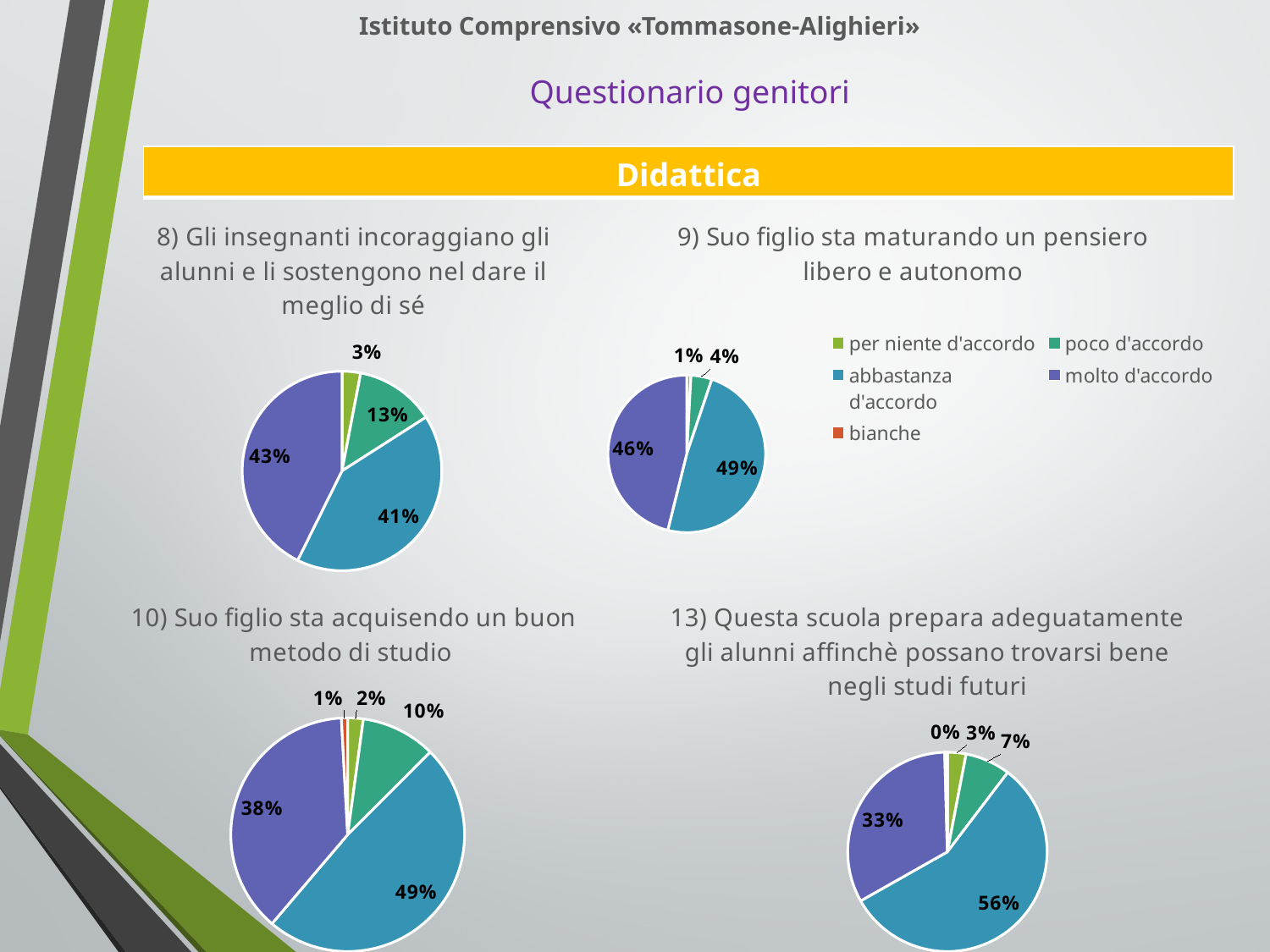
In the chart for question 10 (Suo figlio sta acquisendo un buon metodo di studio), what percentage is shown for 'abbastanza d'accordo'? 49% In the chart for question 13, which is larger: 'molto d'accordo' or 'abbastanza d'accordo'? abbastanza d'accordo In the chart for question 13, what percentage is shown for 'poco d'accordo'? 7% In the chart for question 9 (Suo figlio sta maturando un pensiero libero e autonomo), which response has the largest share? abbastanza d'accordo How many entries does the shared legend list? 5 In the chart for question 8 (Gli insegnanti incoraggiano gli alunni...), what percentage is shown for 'molto d'accordo'? 43% What type of chart is used for question 10? pie chart In the chart for question 13 (Questa scuola prepara adeguatamente gli alunni...), what percentage is shown for 'abbastanza d'accordo'? 56% In the chart for question 10, what is the difference between the 'abbastanza d'accordo' and 'molto d'accordo' shares? 11% In the chart for question 8, what is the difference between 'molto d'accordo' and 'abbastanza d'accordo'? 2% In the chart for question 8, what percentage is shown for 'poco d'accordo'? 13% In the chart for question 9, what percentage is shown for 'molto d'accordo'? 46%